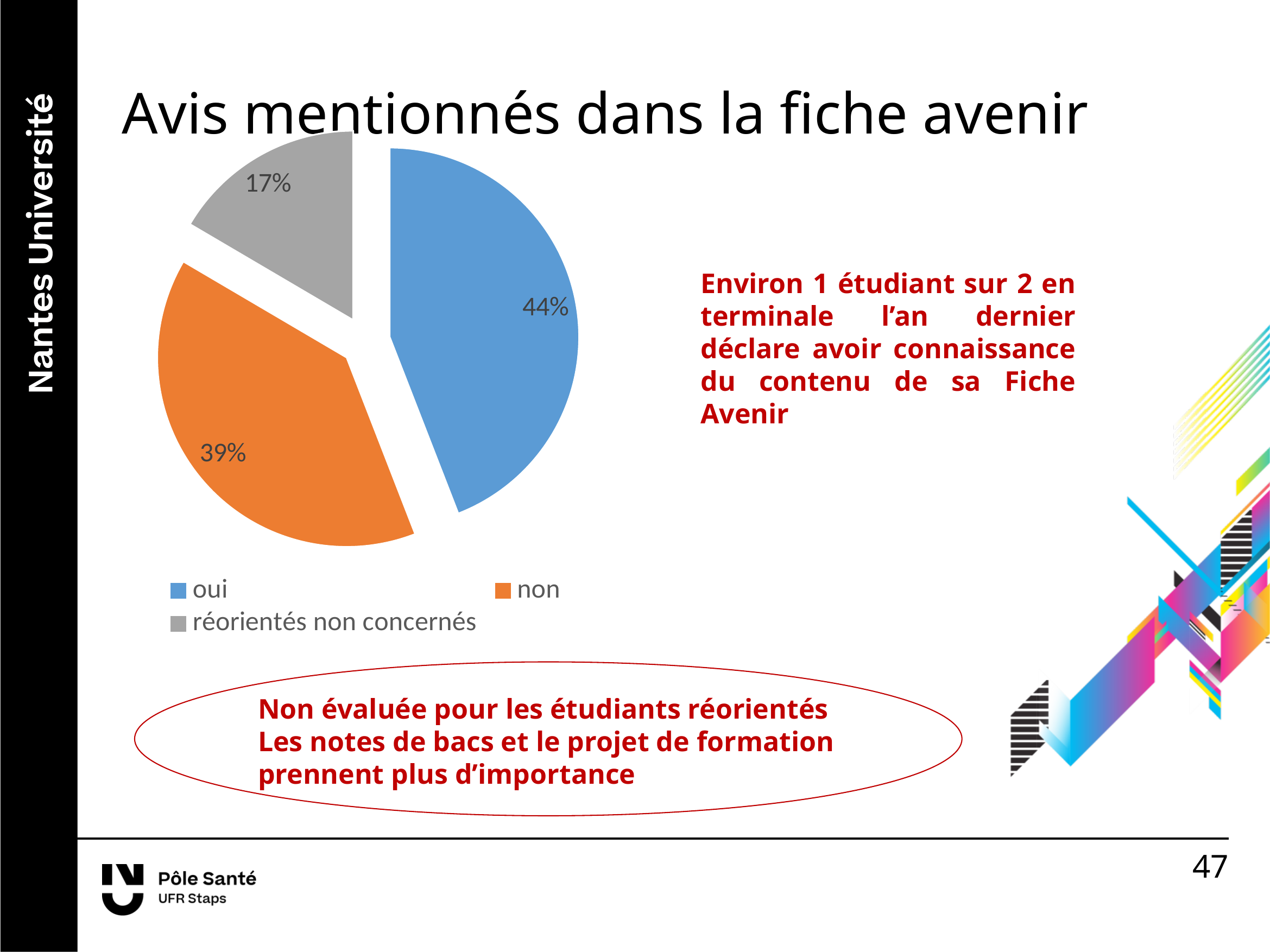
What share of the pie does "non" represent? 39% Which slice is larger, "oui" or "réorientés non concernés"? oui What share of the pie does "réorientés non concernés" represent? 17% What is the title of the slide containing the chart? Avis mentionnés dans la fiche avenir Which category has the smallest slice of the pie? réorientés non concernés Which category has the largest slice of the pie? oui What is the difference in percentage points between the "non" and "réorientés non concernés" slices? 22 What kind of chart is shown on the slide? pie chart What share of the pie does "oui" represent? 44% How many slices does the pie chart have? 3 What is the difference in percentage points between the "oui" and "non" slices? 5 What colour is the "non" slice in the pie chart? orange